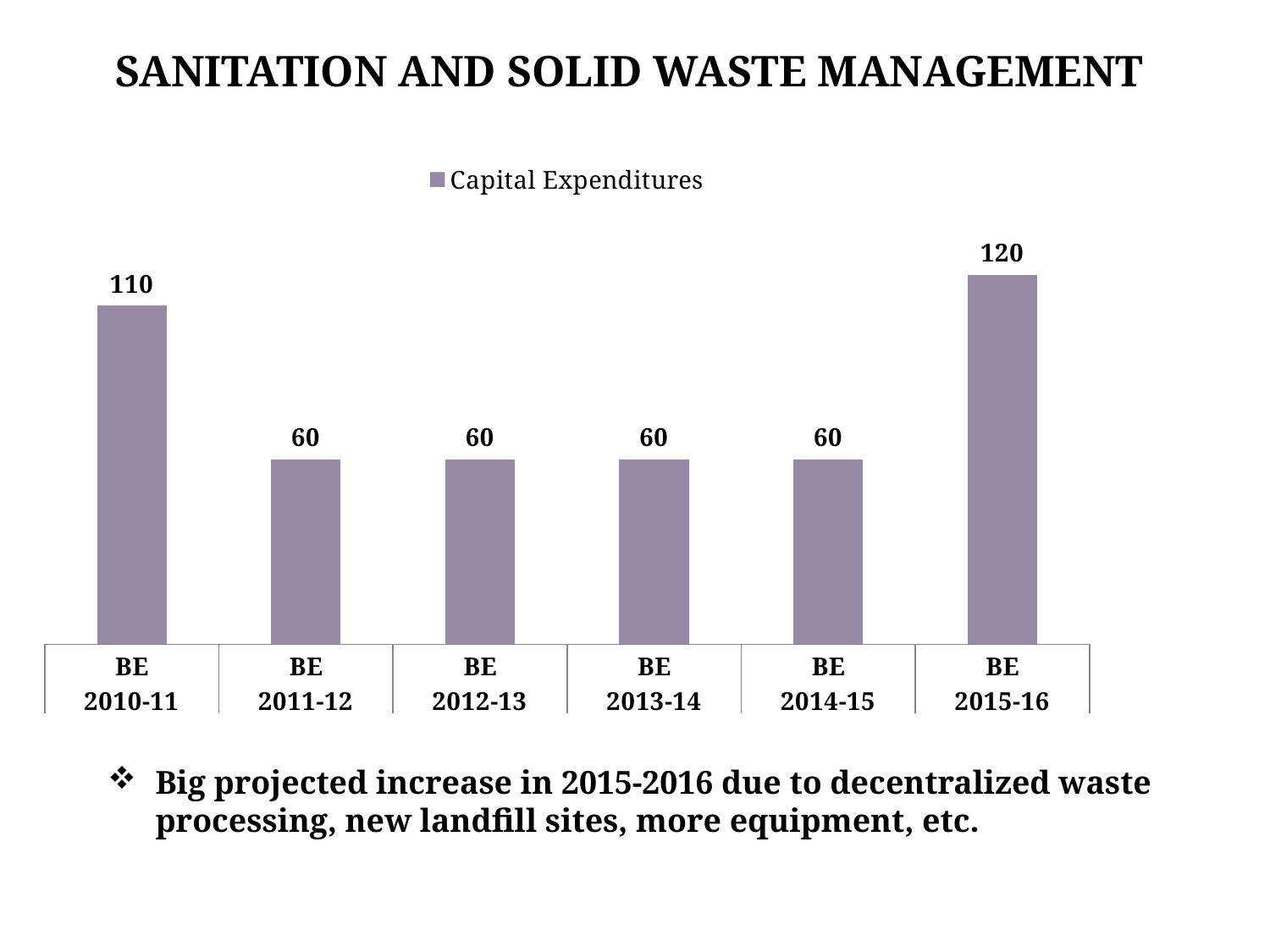
What kind of chart is shown on the slide? Bar chart Which year has the highest Capital Expenditures? BE 2015-16 Which is larger, the Capital Expenditures for BE 2010-11 or for BE 2011-12? BE 2010-11 What is the difference in Capital Expenditures between BE 2015-16 and BE 2010-11? 10 What is the Capital Expenditures value for BE 2010-11? 110 How many years are shown on the x axis of the chart? 6 How many years have a Capital Expenditures value of 60? 4 How many series does the chart legend list? 1 What is the Capital Expenditures value for BE 2013-14? 60 What series name is shown in the chart legend? Capital Expenditures What is the difference in Capital Expenditures between BE 2015-16 and BE 2014-15? 60 What is the Capital Expenditures value for BE 2015-16? 120